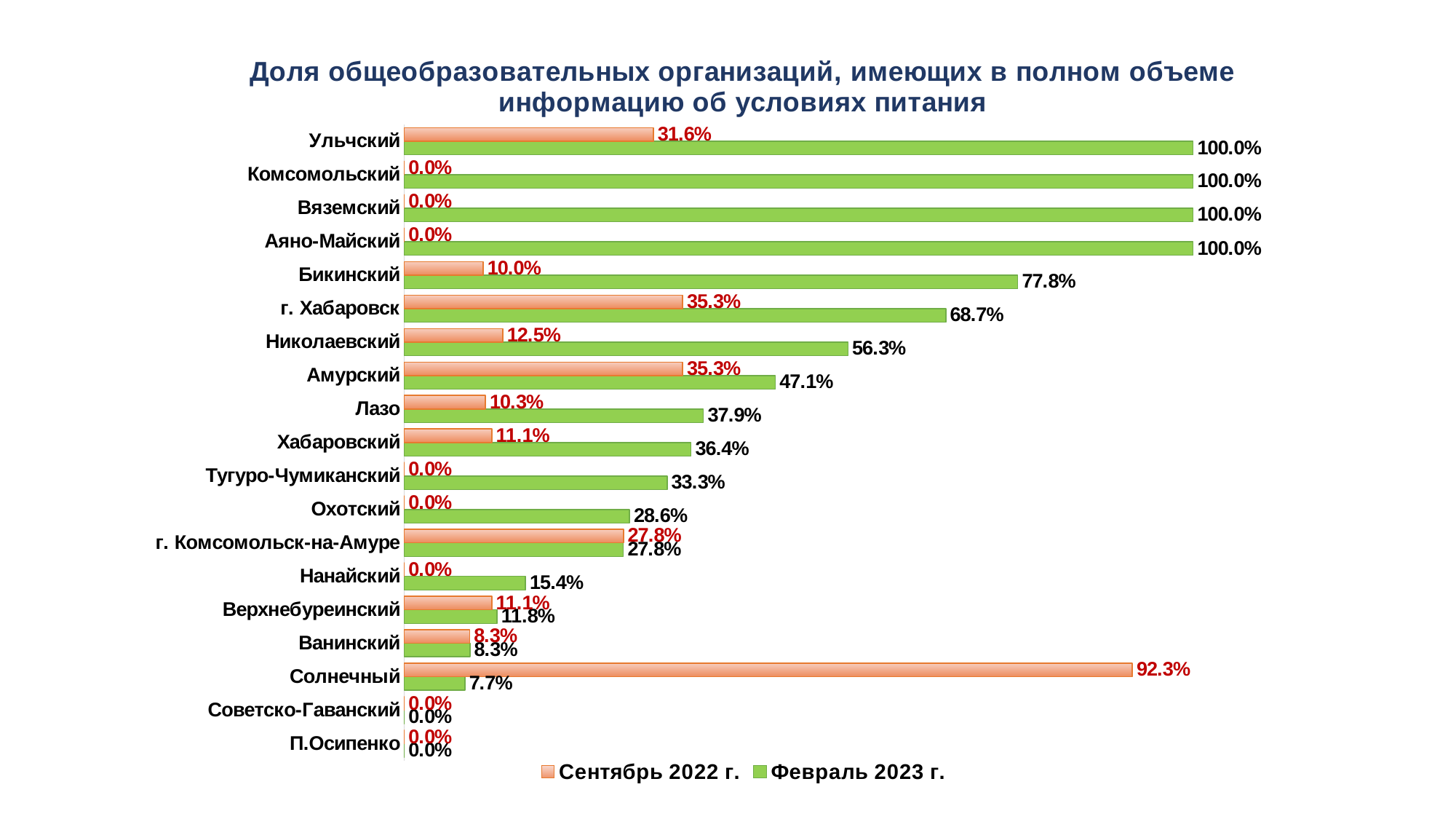
Which category has the highest value in the Сентябрь 2022 г. series? Солнечный What kind of chart is shown on the slide? Bar chart How many series does the legend list? 2 What is the difference between the Февраль 2023 г. and Сентябрь 2022 г. values for Бикинский? 67.8 percentage points What is the value for Николаевский in the Февраль 2023 г. series? 56.3% For Солнечный, which series has the larger value, Сентябрь 2022 г. or Февраль 2023 г.? Сентябрь 2022 г. What is the value for г. Хабаровск in the Сентябрь 2022 г. series? 35.3% What is the difference between the Сентябрь 2022 г. and Февраль 2023 г. values for Солнечный? 84.6 percentage points How many categories are shown on the chart? 19 What is the value for Солнечный in the Февраль 2023 г. series? 7.7% What is the value for Бикинский in the Февраль 2023 г. series? 77.8% For Амурский, which series has the larger value, Сентябрь 2022 г. or Февраль 2023 г.? Февраль 2023 г.